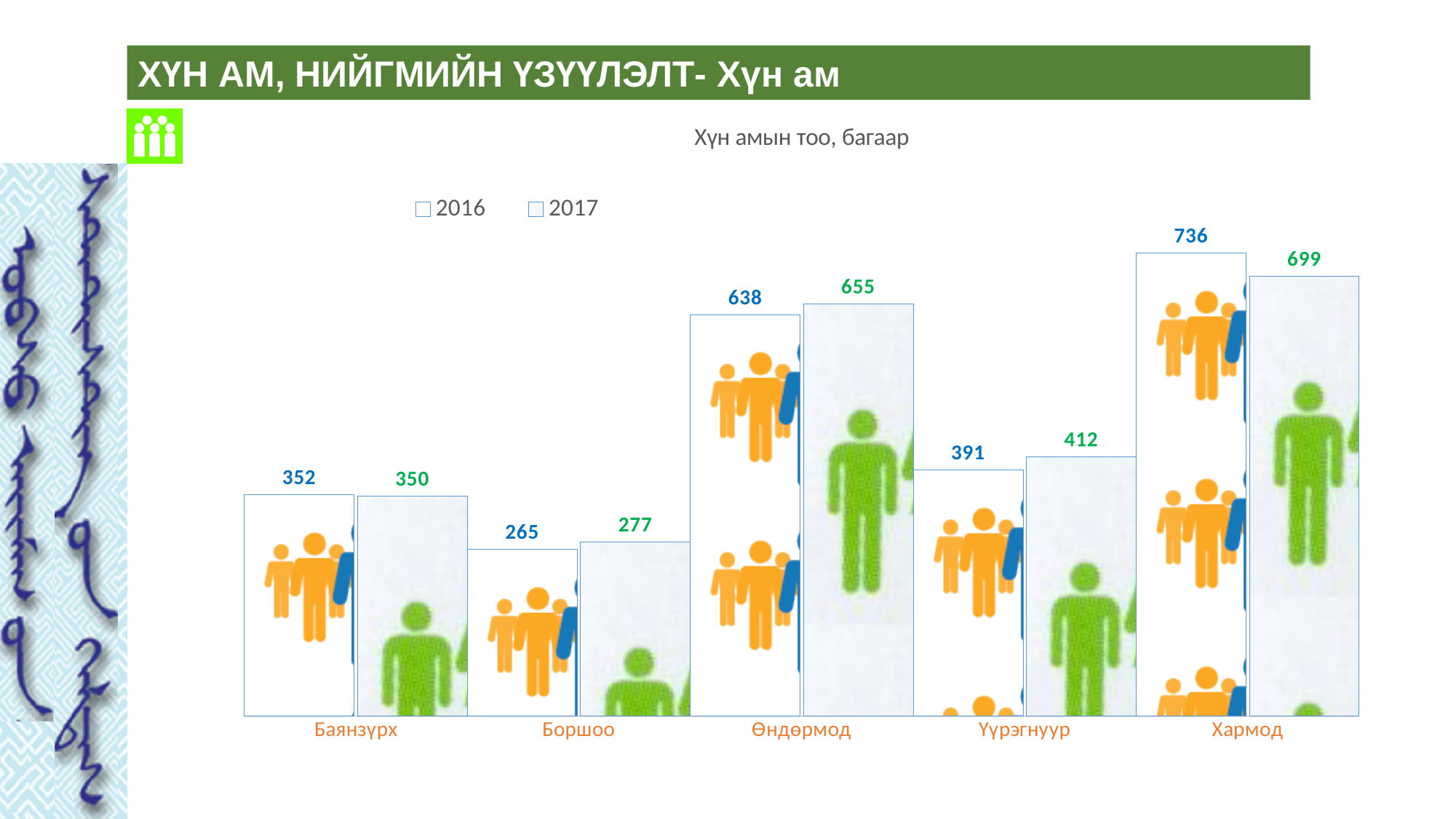
Which category has the highest 2016 value? Хармод Which is larger for Боршоо, the 2016 value or the 2017 value? 2017 Which category has the lowest 2017 value? Боршоо How many series does the legend list? 2 What kind of chart is shown on the slide? bar chart How many categories are shown on the x axis? 5 What is the title of the chart? Хүн амын тоо, багаар What is the difference between the 2016 and 2017 values for Хармод? 37 What is the 2017 value for Баянзүрх? 350 What is the difference between the 2017 values for Өндөрмод and Үүрэгнуур? 243 What is the 2016 value for Өндөрмод? 638 What is the 2017 value for Үүрэгнуур? 412